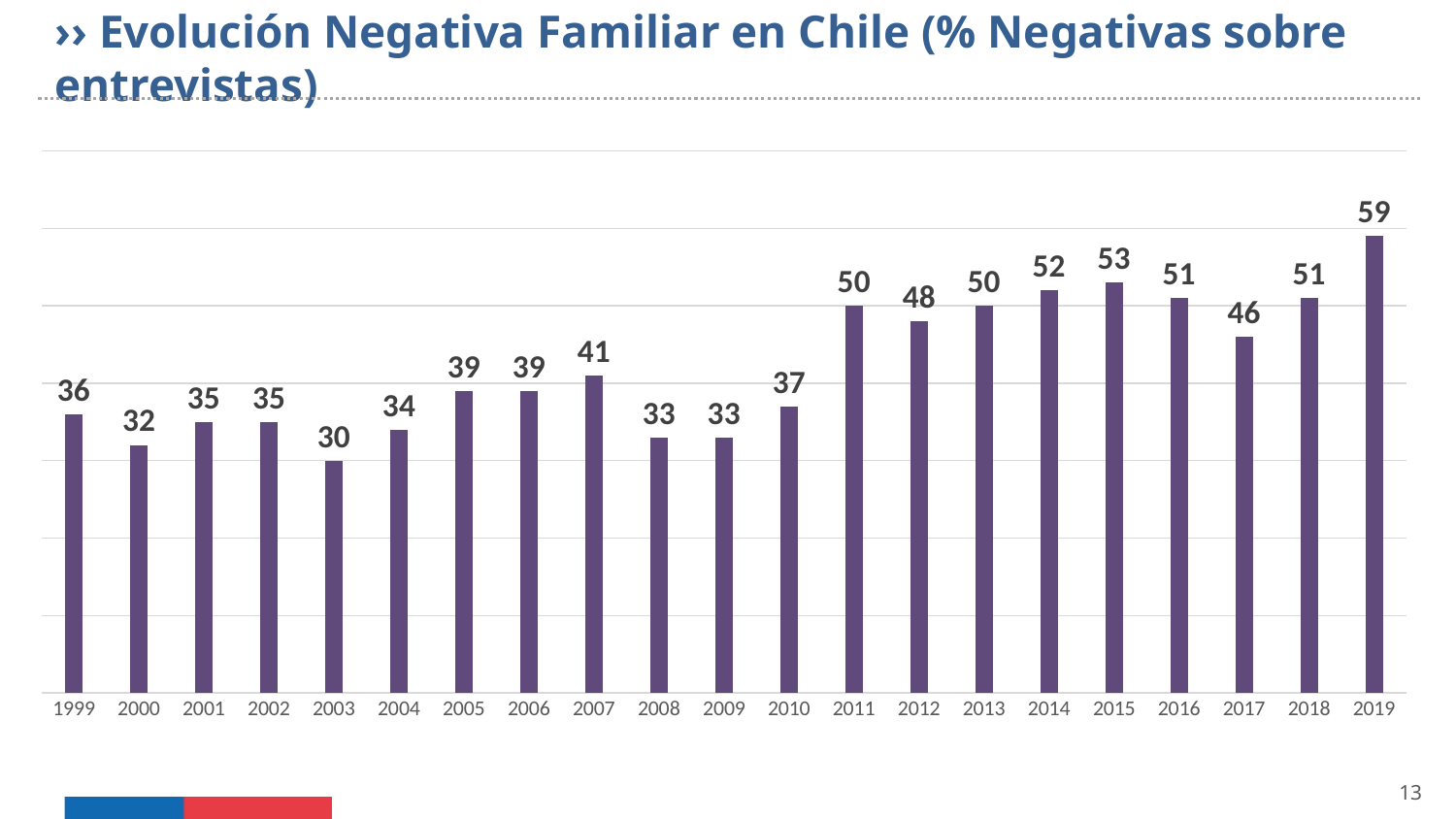
What is the value for 2017? 46 What is the value for 2003? 30 What is the difference between the values for 2010 and 2011? 13 How many years are shown on the x axis? 21 What kind of chart is this? bar chart What is the difference between the values for 2019 and 1999? 23 What is the title of the chart? Evolución Negativa Familiar en Chile (% Negativas sobre entrevistas) Which is larger, the value for 2015 or the value for 2016? 2015 Which year has the highest value? 2019 Do the values generally rise or fall from 1999 to 2019? rise Which year has the lowest value? 2003 What is the value for 2011? 50